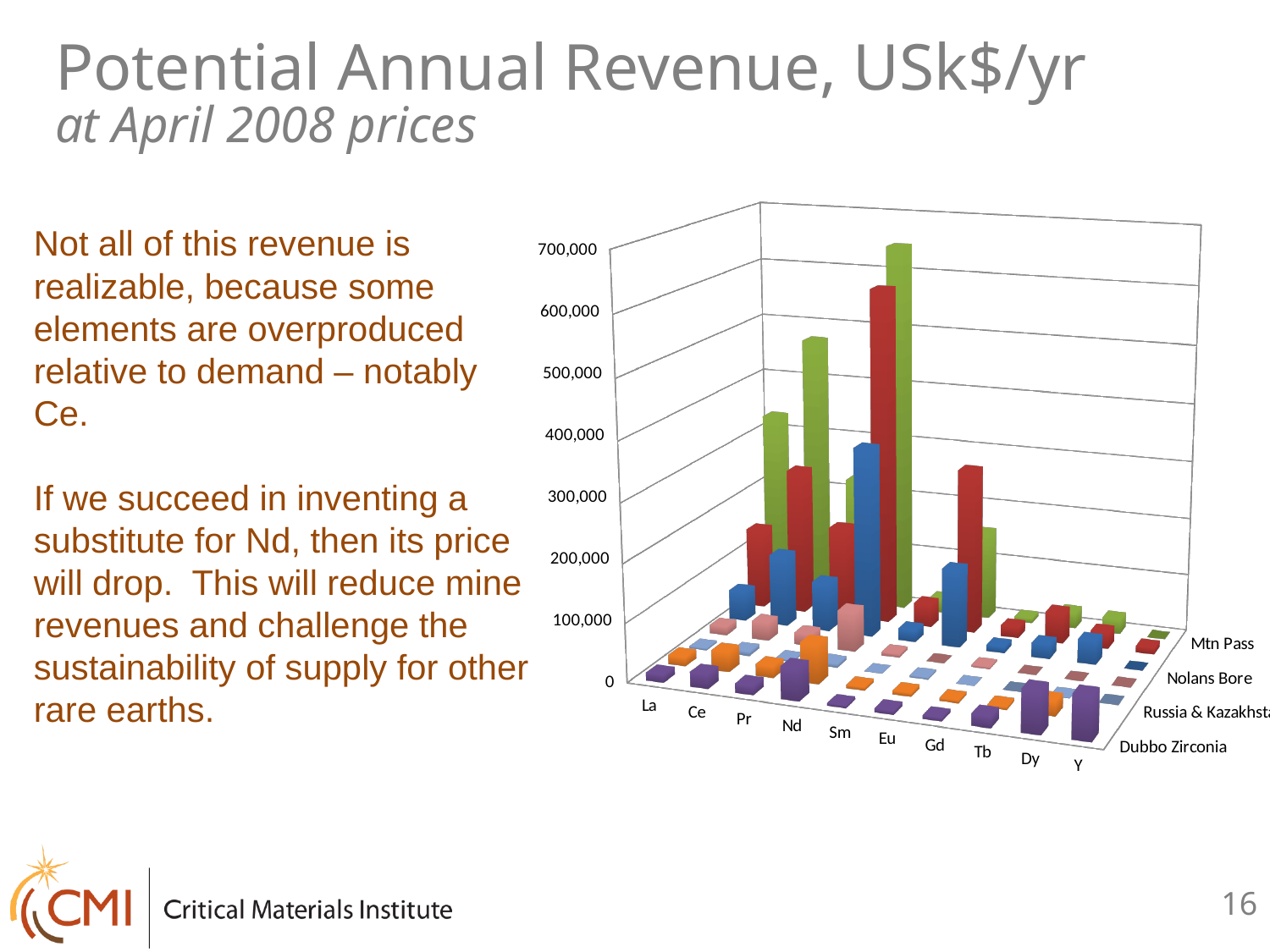
At Nd, which is larger: the Mtn Pass bar or the Nolans Bore bar? Mtn Pass Is the value for Mtn Pass at Nd greater or less than 500,000? greater Which series has the tallest bar in the chart? Mtn Pass What kind of chart is shown on the slide? bar chart What is the highest value shown on the vertical axis of the chart? 700,000 Which element has the tallest bar in the chart? Nd How many elements are listed along the x axis of the chart? 10 Which series is drawn in green in the chart? Mtn Pass Is the value for Dubbo Zirconia at Nd greater or less than 100,000? less